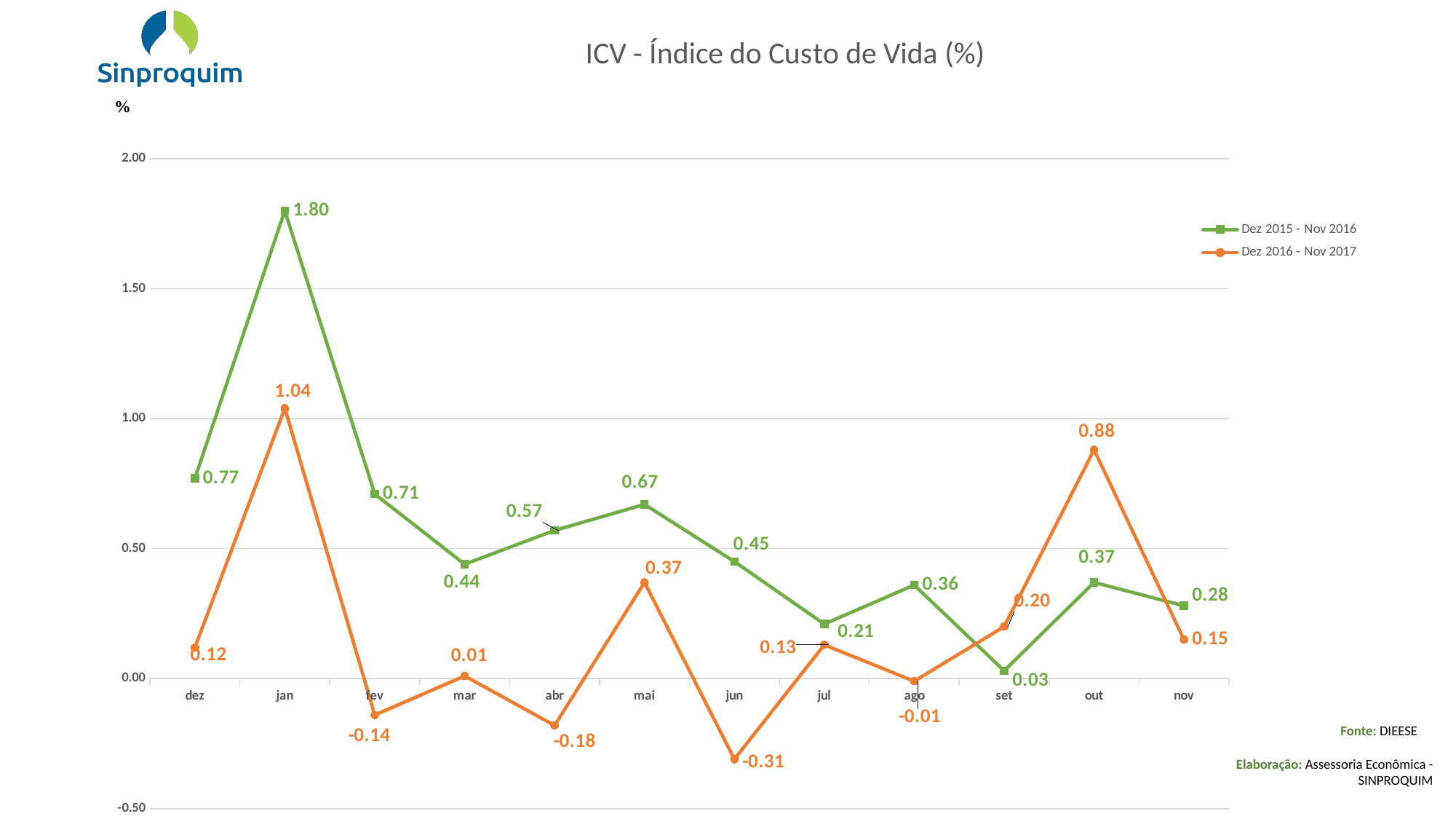
In set, which series has the larger value, Dez 2015 - Nov 2016 or Dez 2016 - Nov 2017? Dez 2016 - Nov 2017 What is the difference between the jan values of the Dez 2015 - Nov 2016 and Dez 2016 - Nov 2017 series? 0.76 What kind of chart is shown on the slide? line chart Which month has the lowest value in the Dez 2016 - Nov 2017 series? jun How many series does the legend list? 2 What is the value for jun in the Dez 2016 - Nov 2017 series? -0.31 What is the value for jan in the Dez 2015 - Nov 2016 series? 1.80 How many months are plotted along the x axis? 12 What is the value for out in the Dez 2016 - Nov 2017 series? 0.88 What is the title of the chart? ICV - Índice do Custo de Vida (%) Which month has the highest value in the Dez 2015 - Nov 2016 series? jan Which month has the lowest value in the Dez 2015 - Nov 2016 series? set